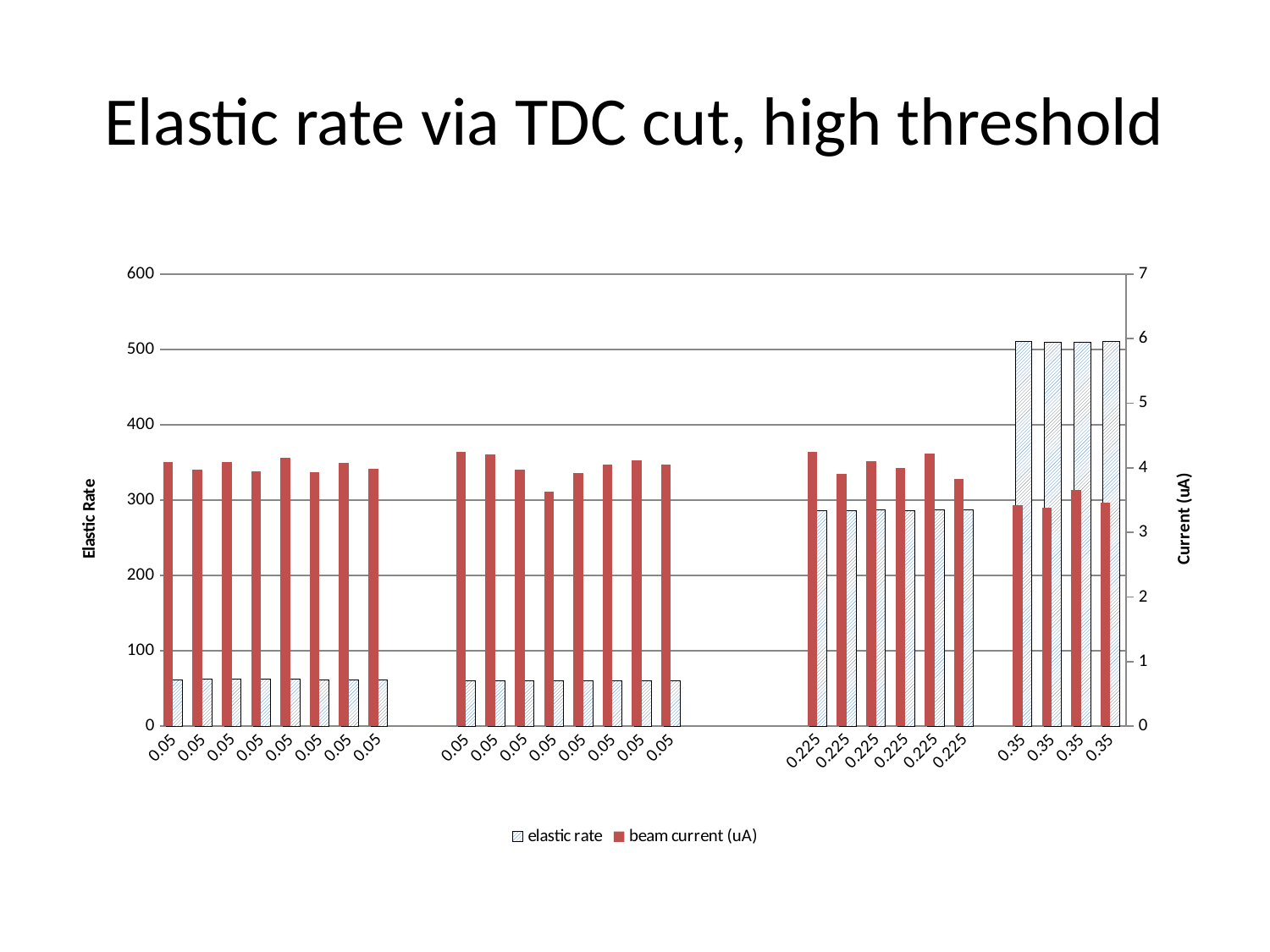
Is the elastic rate for the 0.35 runs greater or less than 400? greater Is the elastic rate for the 0.05 runs greater or less than 100? less What are the two series named in the legend? elastic rate and beam current (uA) How many series does the legend list? 2 How many bars are plotted for the elastic rate series? 26 Is the beam current for the 0.05 runs greater or less than 3 uA? greater What kind of chart is shown on the slide? bar chart Does the elastic rate rise or fall as the x-axis value increases from 0.05 to 0.35? rise Which x-axis value has the highest elastic rate: 0.05, 0.225 or 0.35? 0.35 What is the title of the chart? Elastic rate via TDC cut, high threshold